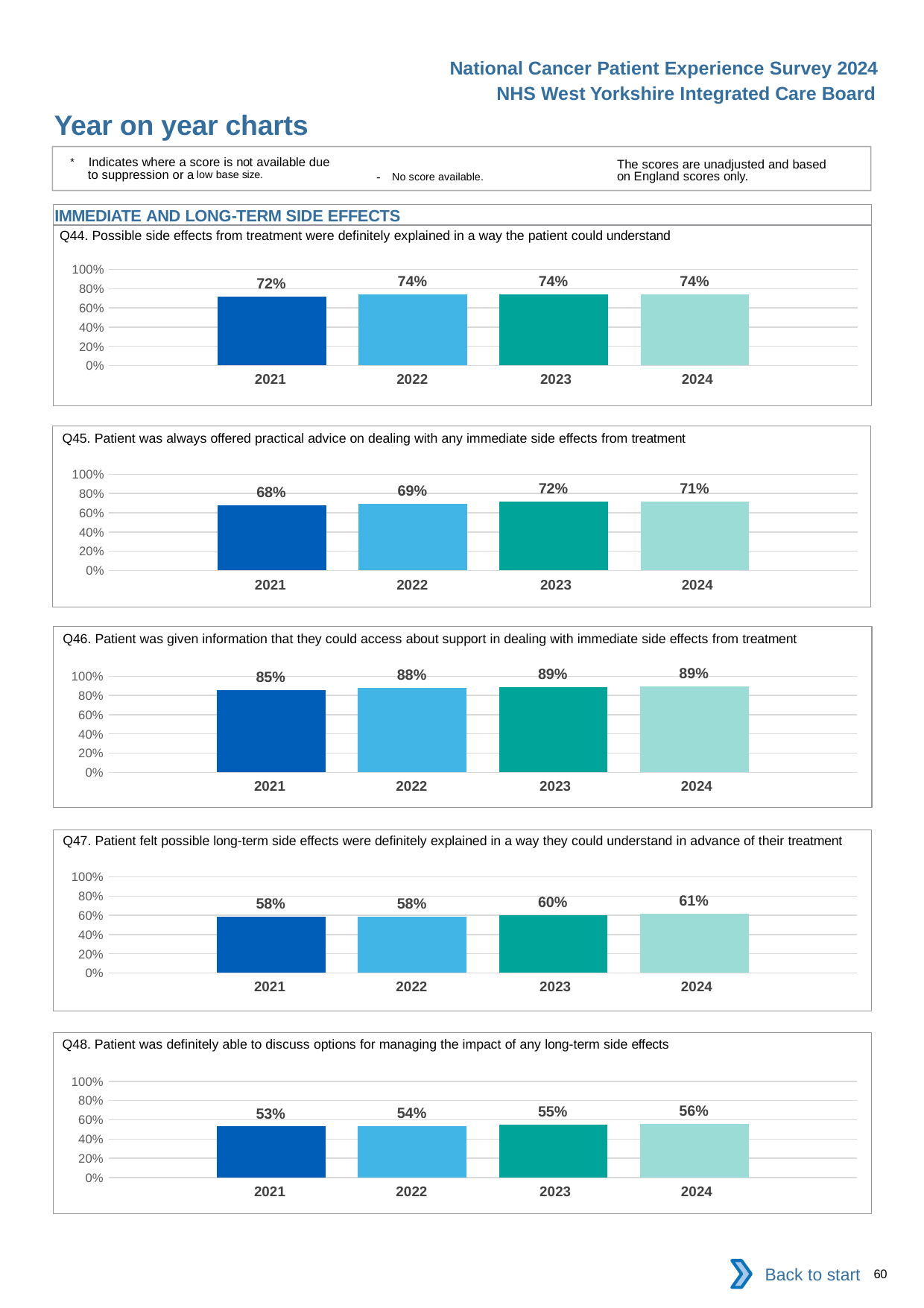
In the Q45 chart, what is the difference between the 2023 and 2021 values? 4 percentage points In the Q48 chart, what is the difference between the 2024 and 2021 values? 3 percentage points In the Q46 chart, what is the value for 2022? 88% In the Q47 chart, which is larger, the value for 2024 or the value for 2021? 2024 In the Q44 chart, what is the value for 2021? 72% In the Q46 chart, which year has the lowest value? 2021 In the Q48 chart, do the values rise or fall from 2021 to 2024? rise How many years are shown on the x axis of the Q44 chart? 4 In the Q48 chart, what is the value for 2024? 56% What kind of chart is the Q46 chart? bar chart In the Q45 chart, which year has the highest value? 2023 In the Q47 chart, what is the value for 2023? 60%